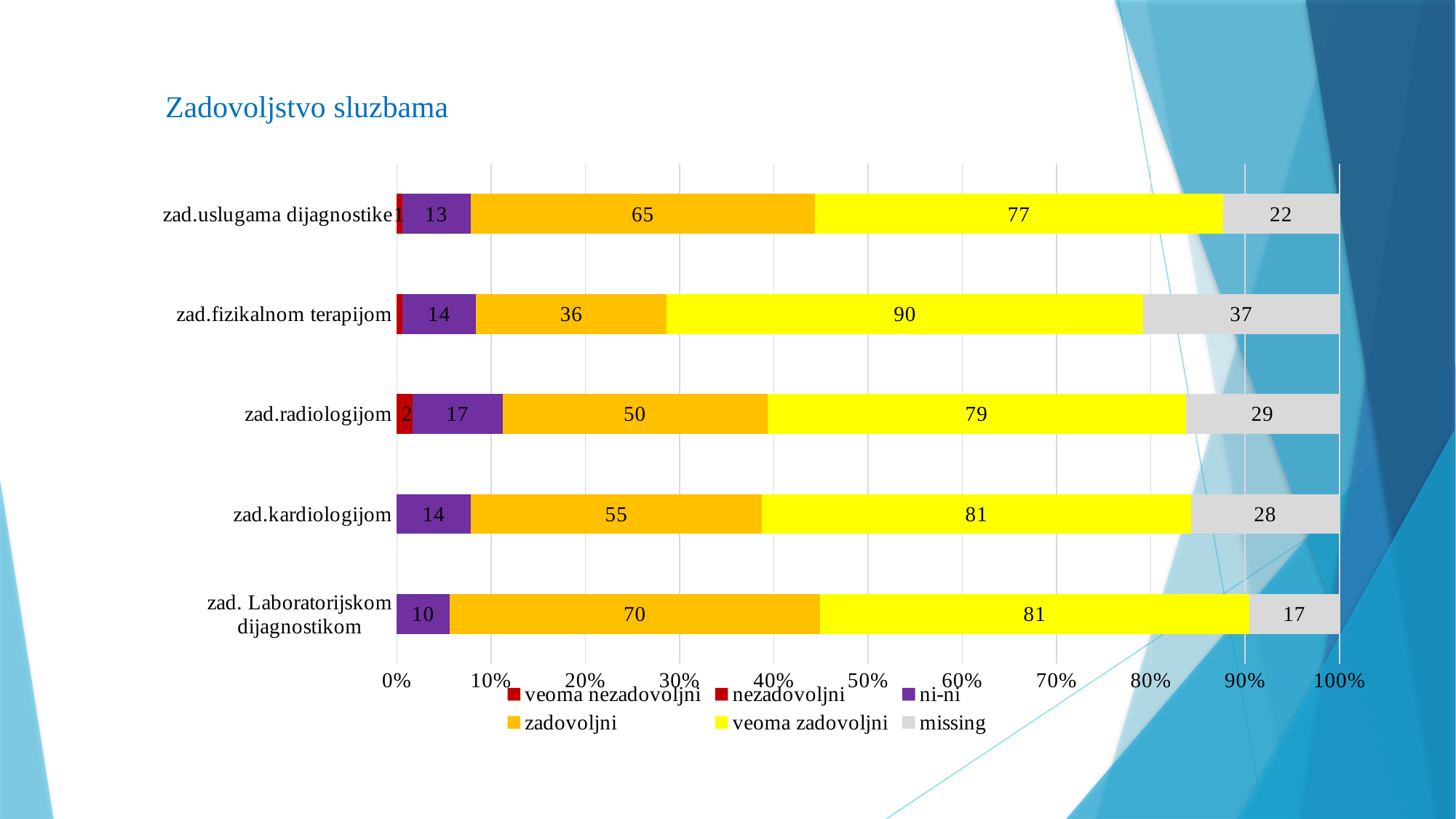
What is the title of the chart? Zadovoljstvo sluzbama Which category has the lowest 'missing' value? zad. Laboratorijskom dijagnostikom What is the 'zadovoljni' value for zad. Laboratorijskom dijagnostikom? 70 How many series does the legend list? 6 What is the total of all labelled segments in the zad.kardiologijom bar? 178 What is the difference between the 'zadovoljni' values for zad.uslugama dijagnostike and zad.fizikalnom terapijom? 29 Which category has the highest 'veoma zadovoljni' value? zad.fizikalnom terapijom How many categories are plotted on the chart? 5 What is the 'veoma zadovoljni' value for zad.fizikalnom terapijom? 90 What is the 'missing' value for zad.radiologijom? 29 What type of chart is shown on the slide? Stacked bar chart Which has the larger 'ni-ni' value, zad.radiologijom or zad.kardiologijom? zad.radiologijom